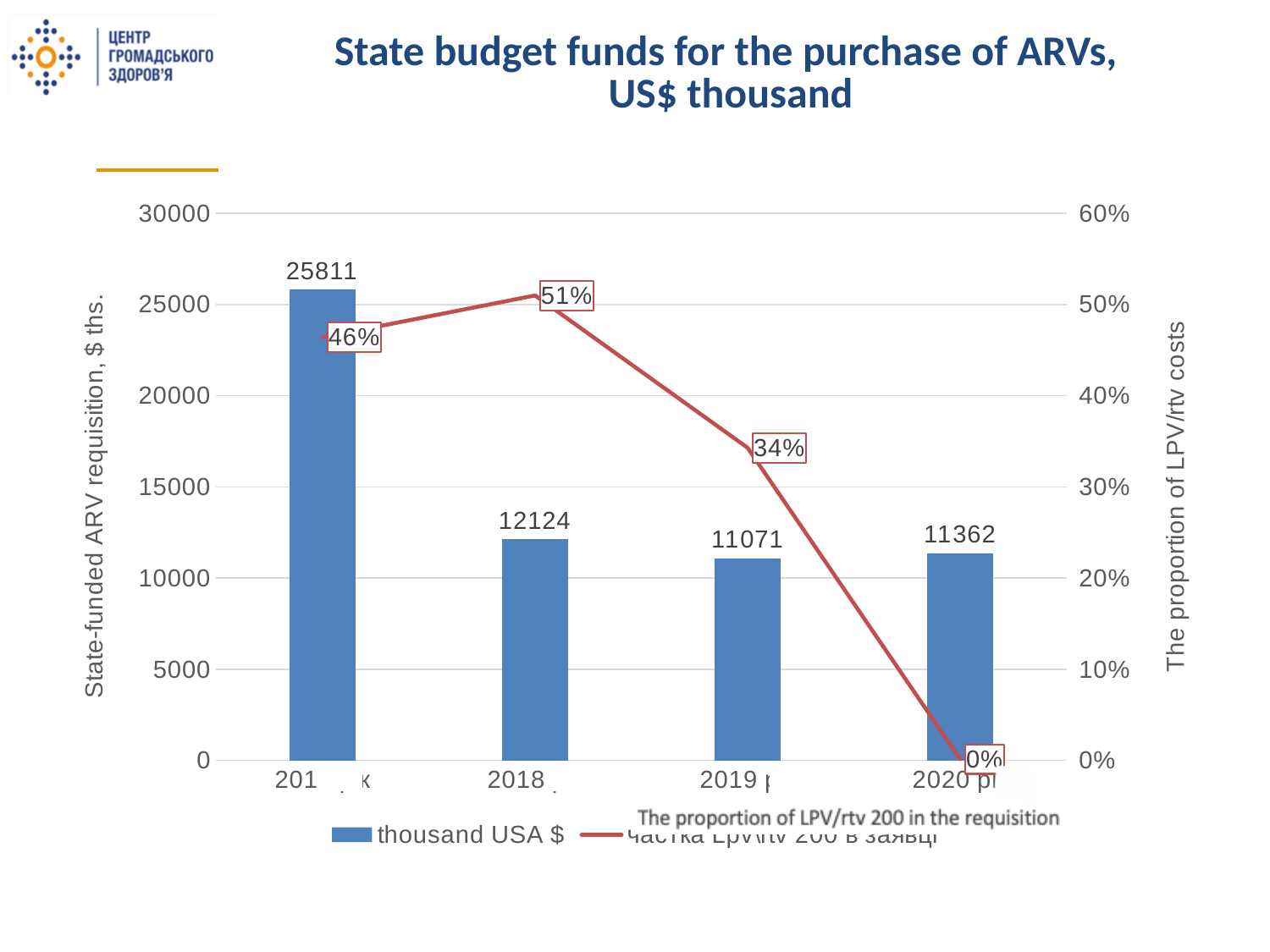
What is the value of the thousand USA $ bar for 2020? 11362 Does the proportion of LPV/rtv 200 rise or fall from 2018 to 2020? fall What is the value of the thousand USA $ bar for 2018? 12124 What is the proportion of LPV/rtv 200 in the requisition shown for 2019? 34% Which year has the highest proportion of LPV/rtv 200 in the requisition? 2018 Which year has the lowest thousand USA $ bar? 2019 What is the value of the thousand USA $ bar for 2019? 11071 By how much does the thousand USA $ value for 2020 exceed the value for 2019? 291 How many series does the legend list? 2 Which is larger, the thousand USA $ value for 2018 or for 2020? 2018 What is the proportion of LPV/rtv 200 in the requisition shown for 2018? 51% Which year has the lowest proportion of LPV/rtv 200 in the requisition? 2020